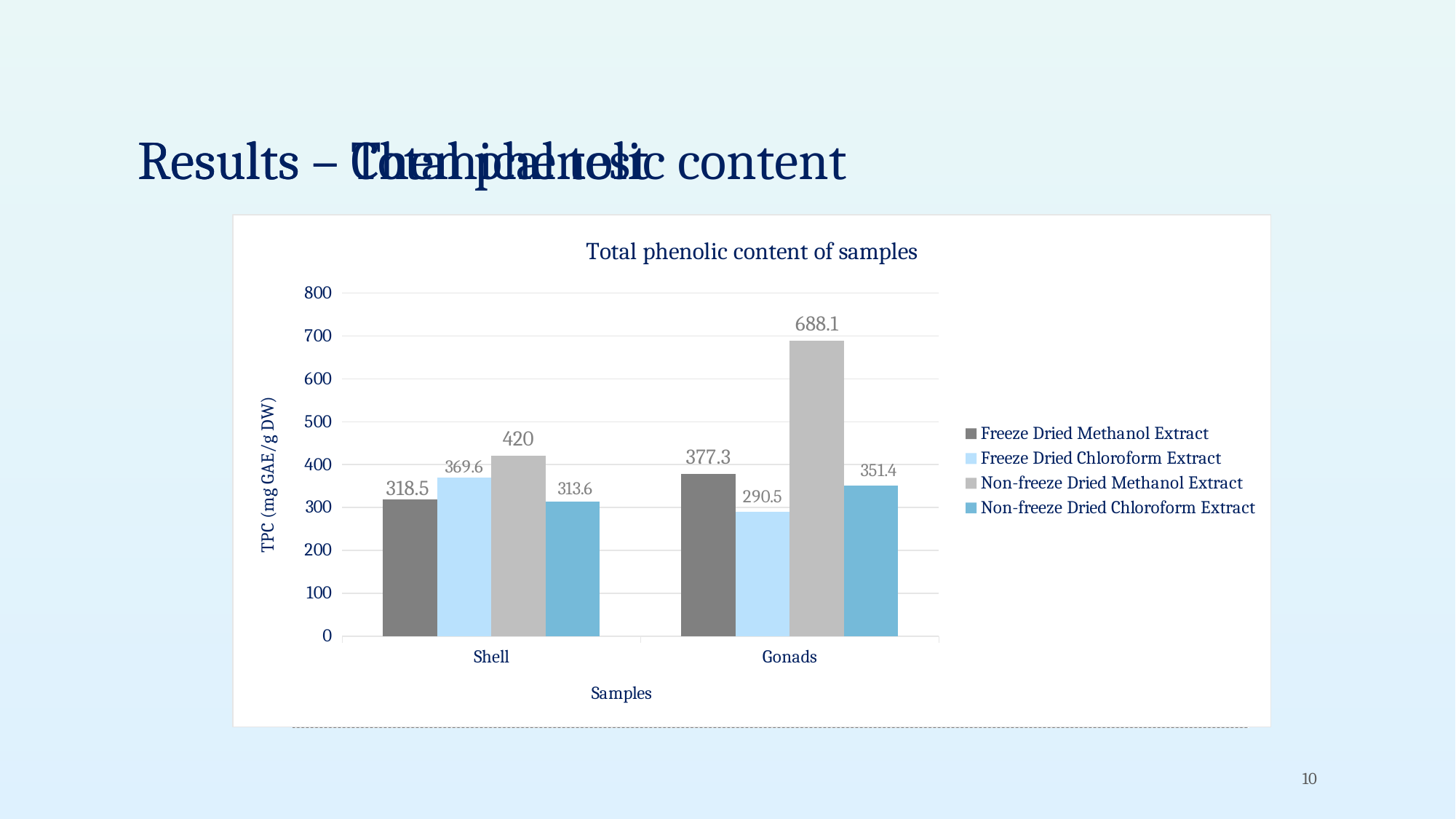
How many series does the legend list? 4 What is the value for the Freeze Dried Methanol Extract for Gonads? 377.3 Which is larger for Shell: the Freeze Dried Chloroform Extract or the Non-freeze Dried Chloroform Extract? Freeze Dried Chloroform Extract What is the value for the Non-freeze Dried Methanol Extract for Gonads? 688.1 Is the value for the Non-freeze Dried Methanol Extract for Gonads greater or less than 600? greater How many sample categories are shown on the x axis? 2 What is the value for the Freeze Dried Chloroform Extract for Shell? 369.6 Which series has the lowest value for Gonads? Freeze Dried Chloroform Extract What is the value for the Non-freeze Dried Chloroform Extract for Shell? 313.6 What is the difference between the Non-freeze Dried Methanol Extract values for Gonads and Shell? 268.1 Which series has the highest value for Gonads? Non-freeze Dried Methanol Extract What kind of chart is shown on the slide? bar chart